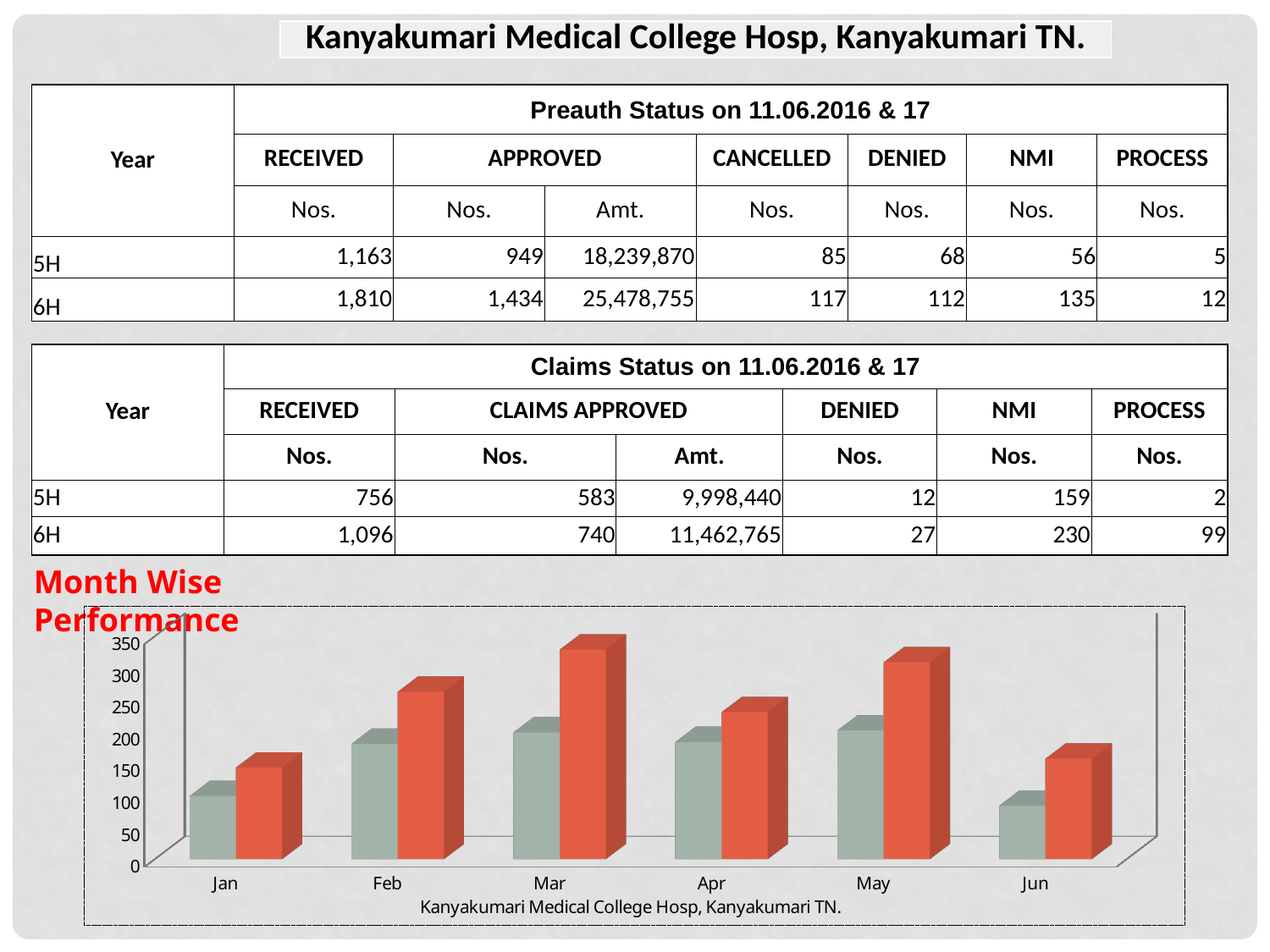
What kind of chart is shown under the heading "Month Wise Performance"? bar chart In the Month Wise Performance chart, is the grey bar for Jun greater or less than 150? less In the Month Wise Performance chart, is the red bar for Mar greater or less than 300? greater What text appears as the axis label beneath the months in the Month Wise Performance chart? Kanyakumari Medical College Hosp, Kanyakumari TN. In the Month Wise Performance chart, which month has the tallest red bar? Mar In the Month Wise Performance chart, is the red bar for May greater or less than 250? greater How many months are shown on the x axis of the Month Wise Performance chart? 6 In the Month Wise Performance chart, which is larger, the red bar for Feb or the red bar for Apr? Feb In the Month Wise Performance chart, which is larger for Mar, the grey bar or the red bar? the red bar In the Month Wise Performance chart, do the red bars rise or fall from Jan to Mar? rise